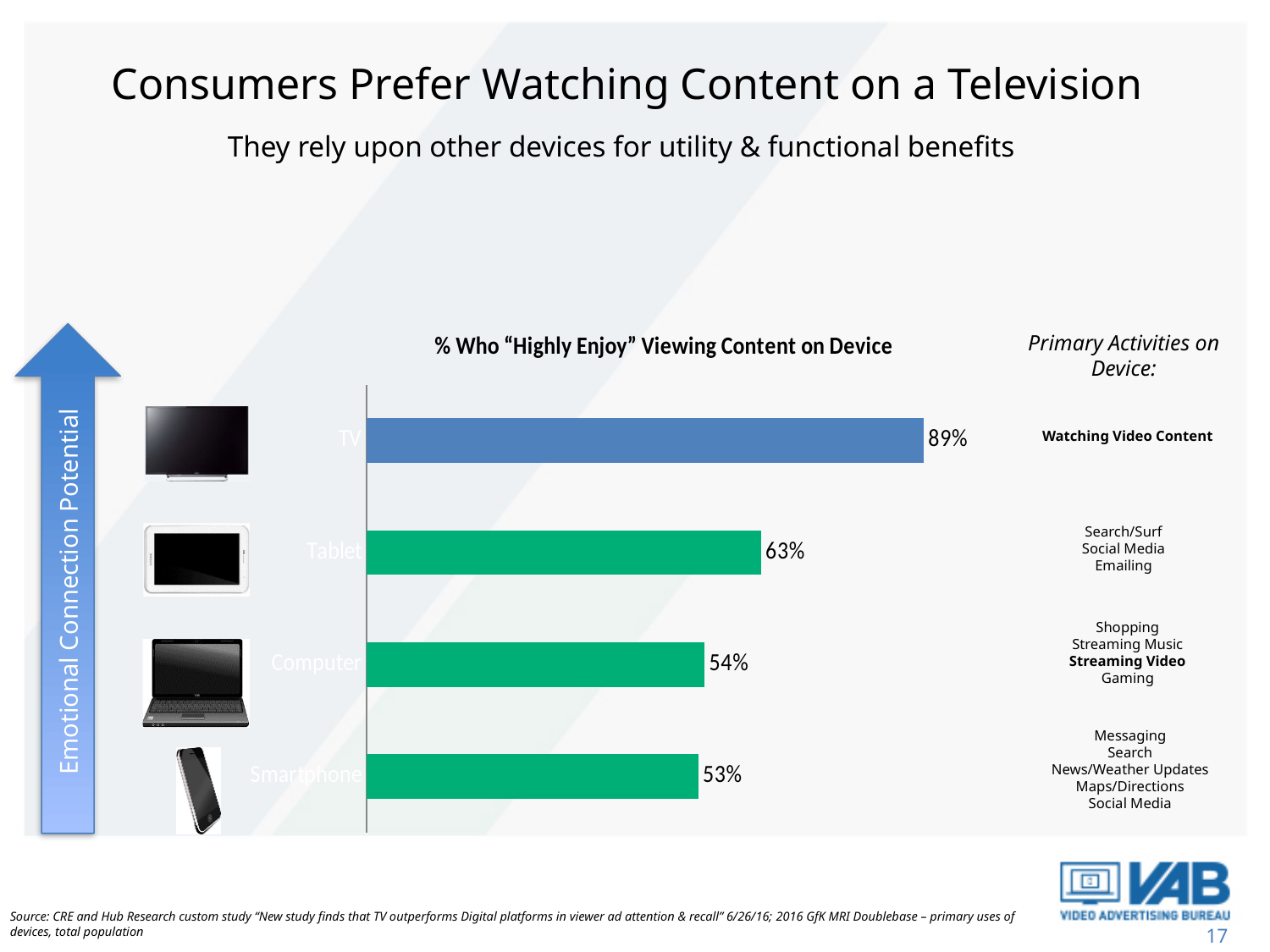
Which device has the lowest value in the chart? Smartphone How many devices are shown in the chart? 4 What is the difference between the Computer value and the Smartphone value? 1% What percentage of consumers "highly enjoy" viewing content on a TV? 89% What is the value shown for Tablet in the chart? 63% What is the title of the chart? % Who "Highly Enjoy" Viewing Content on Device Which device has the highest share of people who "highly enjoy" viewing content on it? TV What is the difference between the TV value and the Tablet value? 26% What is the value for Smartphone in the chart? 53% Which is larger, the value for Tablet or the value for Computer? Tablet What type of chart is used on this slide? Bar chart What percentage is shown for Computer? 54%